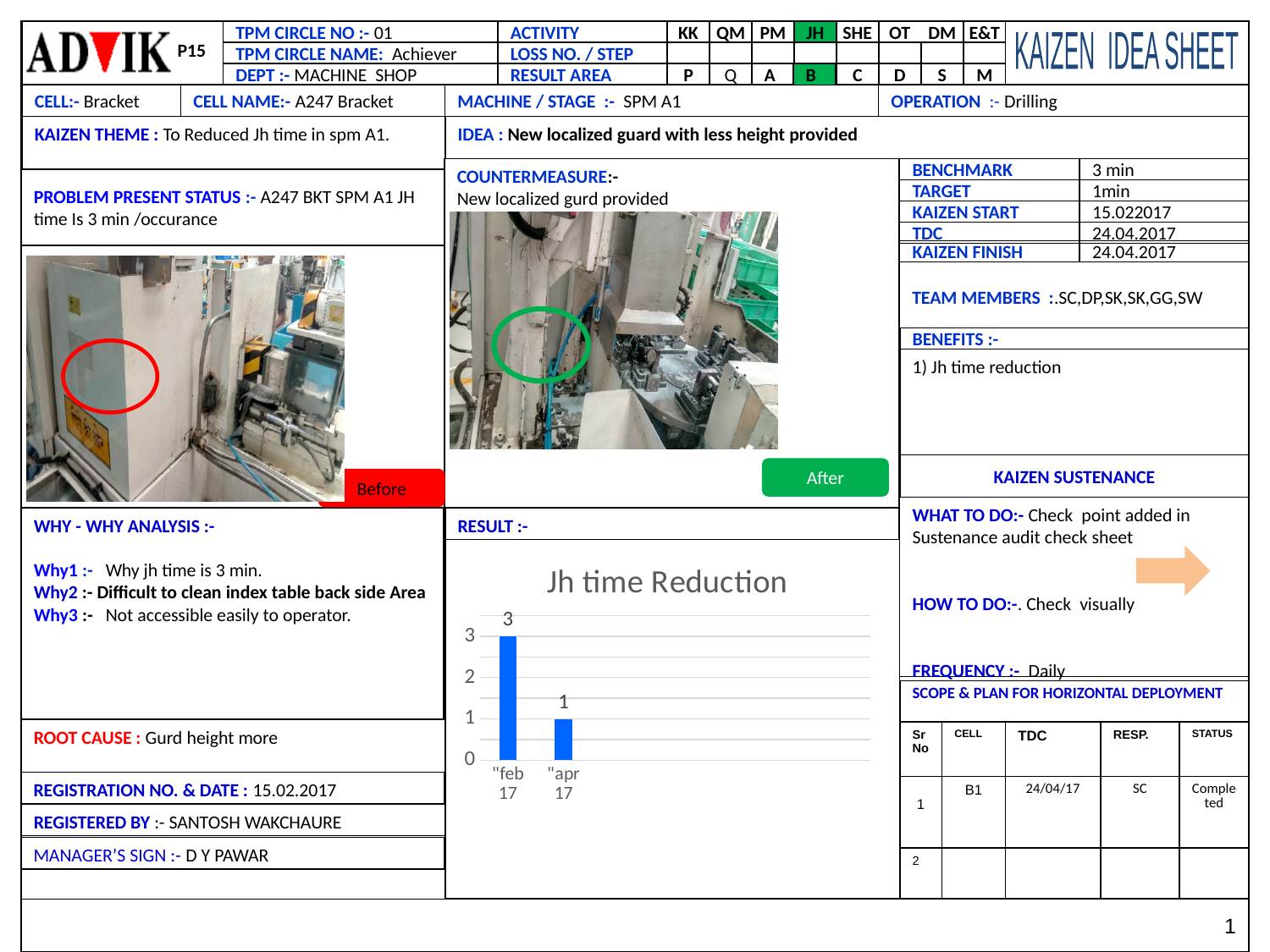
What is the value for "apr 17" in the Jh time Reduction chart? 1 Which category has the highest value in the Jh time Reduction chart? feb 17 What kind of chart is shown under RESULT? bar chart What is the highest tick value shown on the vertical axis of the Jh time Reduction chart? 3 Is the value for "feb 17" in the Jh time Reduction chart greater or less than 2? greater What is the title of the chart on the slide? Jh time Reduction Do the values in the Jh time Reduction chart rise or fall from "feb 17" to "apr 17"? fall Which category has the lowest value in the Jh time Reduction chart? apr 17 What is the value for "feb 17" in the Jh time Reduction chart? 3 What is the difference between the values for "feb 17" and "apr 17" in the Jh time Reduction chart? 2 In the Jh time Reduction chart, which is larger, the value for "feb 17" or "apr 17"? feb 17 How many bars are plotted in the Jh time Reduction chart? 2